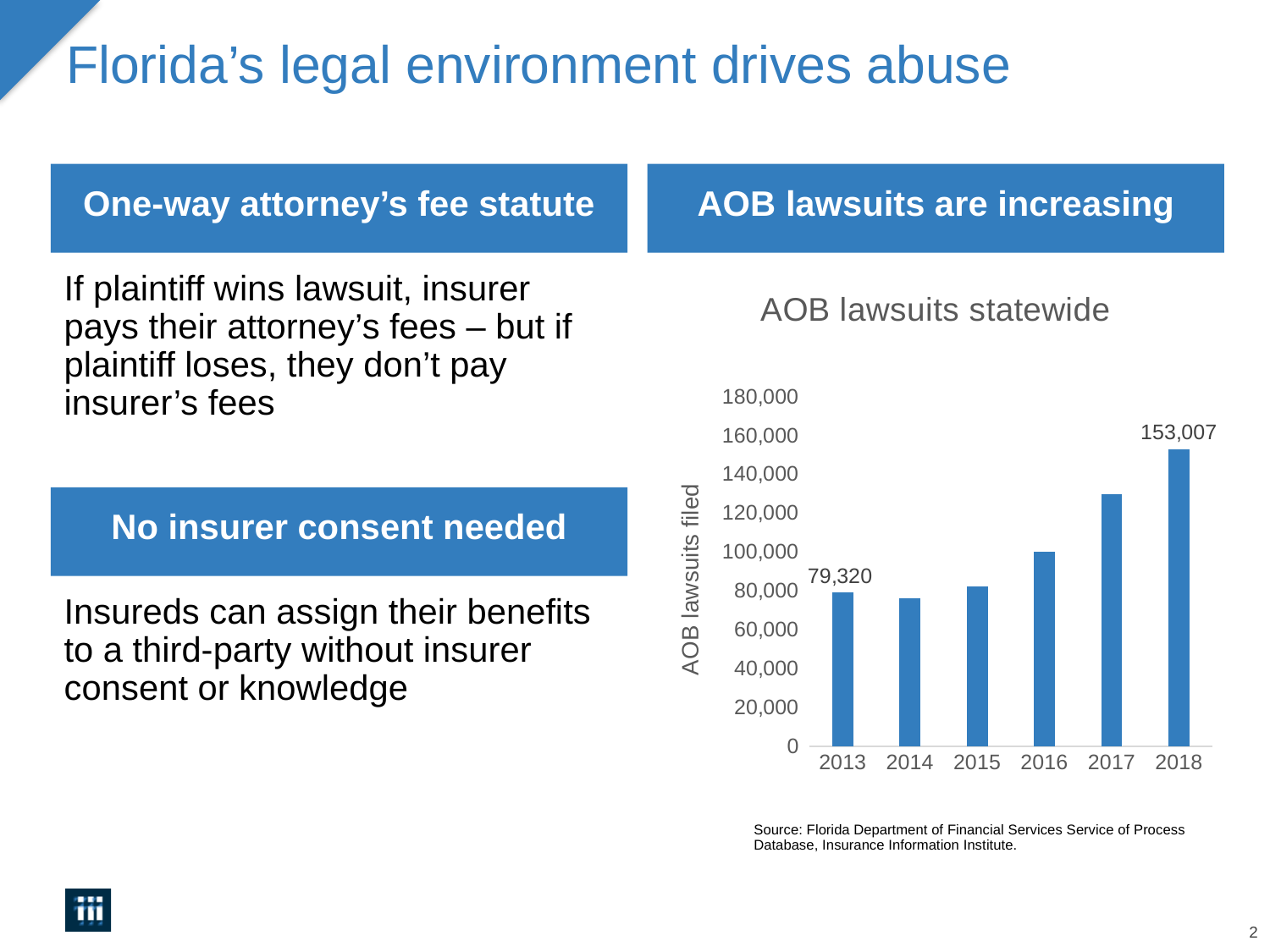
What is the value for 2013 in the AOB lawsuits statewide chart? 79,320 What is the difference between the 2018 and 2013 values in the AOB lawsuits statewide chart? 73,687 Is the value for 2014 greater or less than 100,000? less How many years are shown on the x axis of the AOB lawsuits statewide chart? 6 What is the value for 2018 in the AOB lawsuits statewide chart? 153,007 What kind of chart is used to show AOB lawsuits statewide? bar chart Which year has the highest number of AOB lawsuits filed? 2018 Is the value for 2016 greater or less than 80,000? greater Do AOB lawsuits filed generally rise or fall from 2014 to 2018? rise Is the value for 2017 greater or less than 120,000? greater Which is larger, the value for 2017 or the value for 2016? 2017 What is the label on the vertical axis of the chart? AOB lawsuits filed